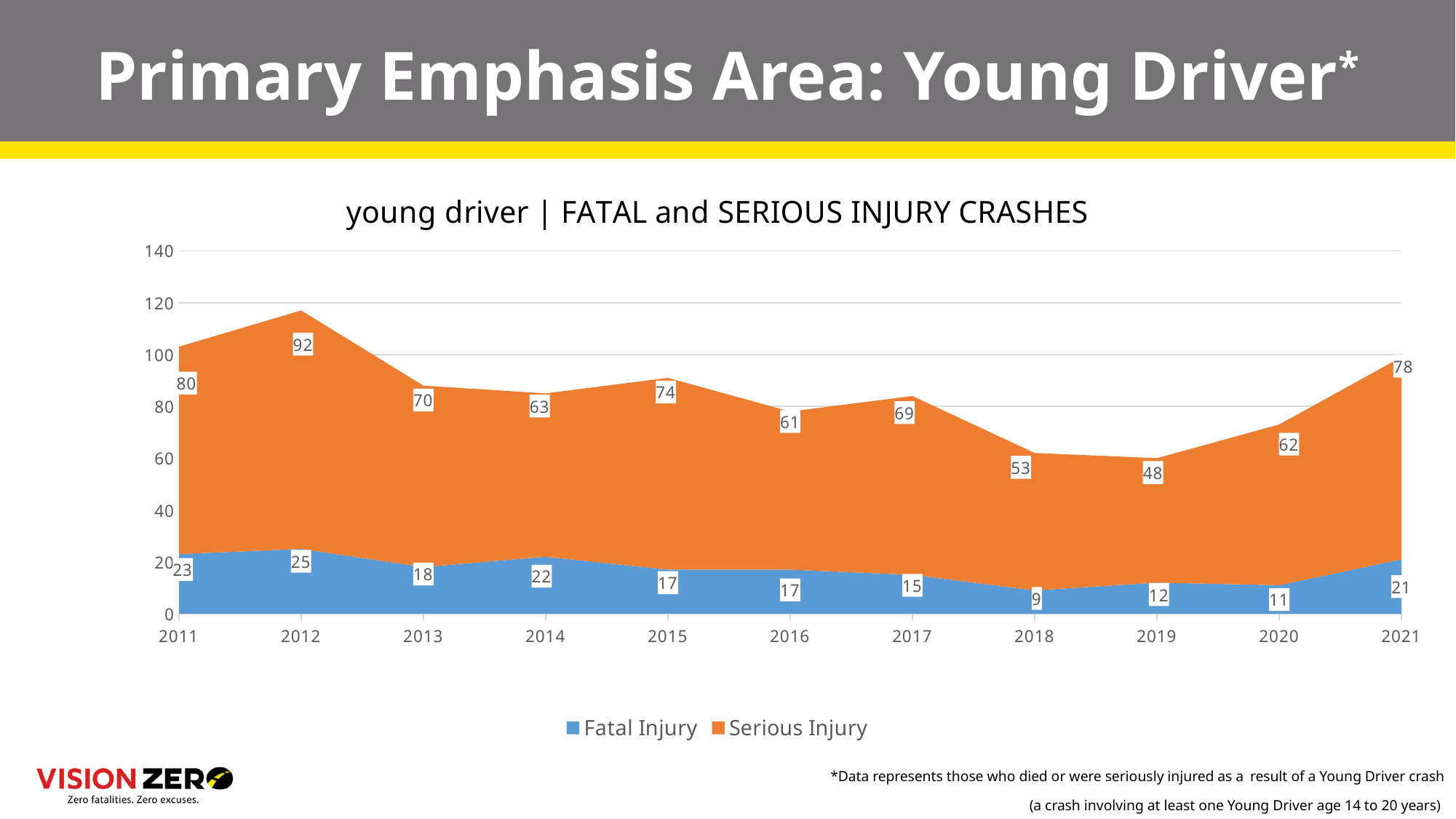
How many years are shown on the x axis? 11 What is the difference between the Serious Injury values for 2012 and 2019? 44 Which year has the lowest Serious Injury value? 2019 What is the total of Fatal Injury and Serious Injury for 2011? 103 Is the Fatal Injury value for 2013 larger or smaller than the Fatal Injury value for 2014? smaller Which year has the lowest Fatal Injury value? 2018 What kind of chart is shown on the slide? Stacked area chart Which year has the highest Serious Injury value? 2012 What is the Fatal Injury value for 2018? 9 What is the Serious Injury value for 2012? 92 What is the Serious Injury value for 2021? 78 How many series does the legend list? 2